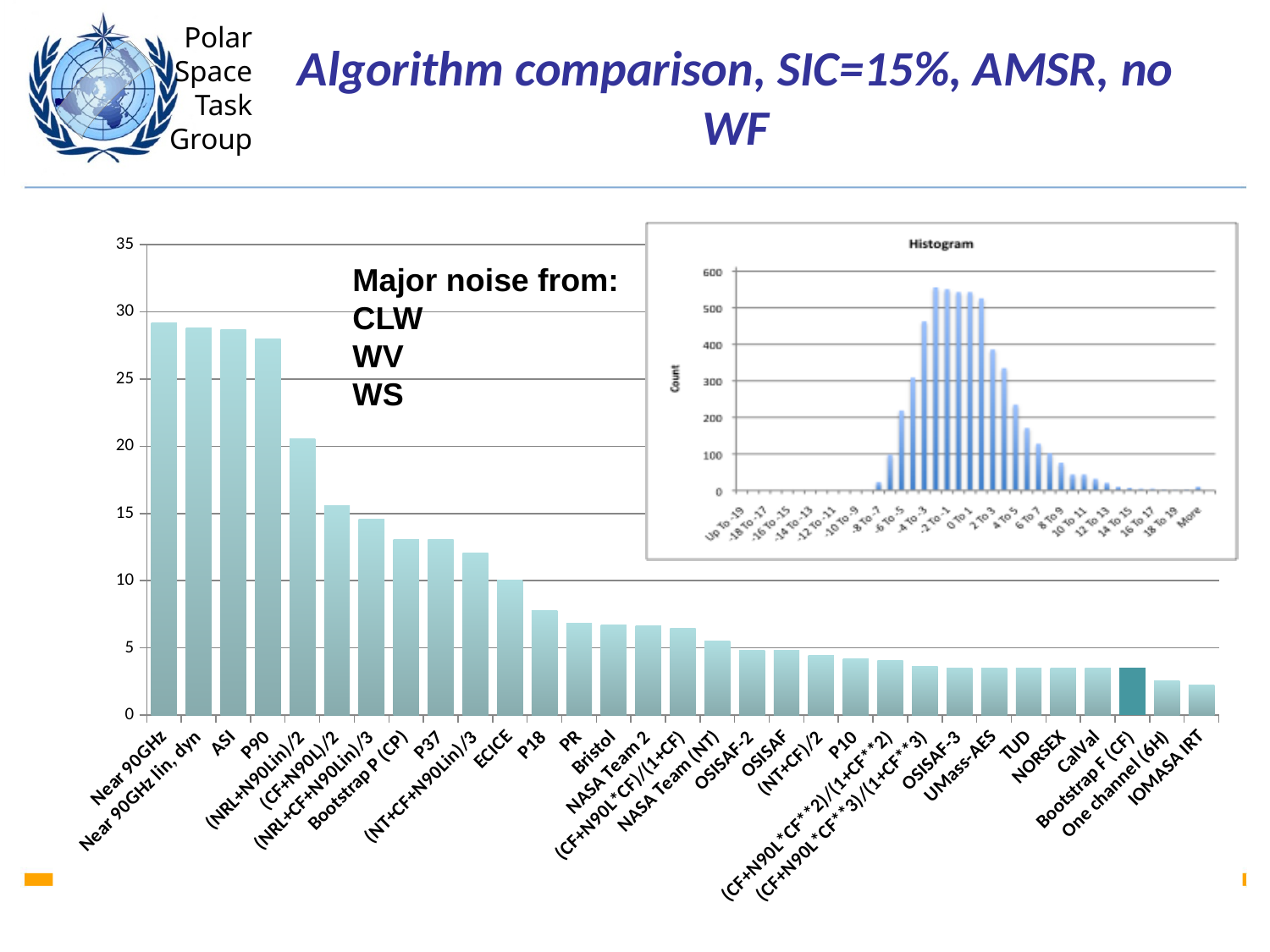
In the large bar chart, which has the larger value, ECICE or OSISAF? ECICE What kind of chart is the large chart on the left of the slide? bar chart In the large bar chart, is the value for IOMASA IRT greater or less than 5? less In the large bar chart, which bar is drawn in a darker colour than the others? Bootstrap F (CF) In the large bar chart, is the value for (NRL+N90Lin)/2 greater or less than 20? greater What is the title of the inset chart in the upper right? Histogram In the large bar chart, is the value for Near 90GHz greater or less than 25? greater In the large bar chart, which has the larger value, (CF+N90L)/2 or P37? (CF+N90L)/2 In the large bar chart, do the values generally rise or fall from left to right along the x axis? fall